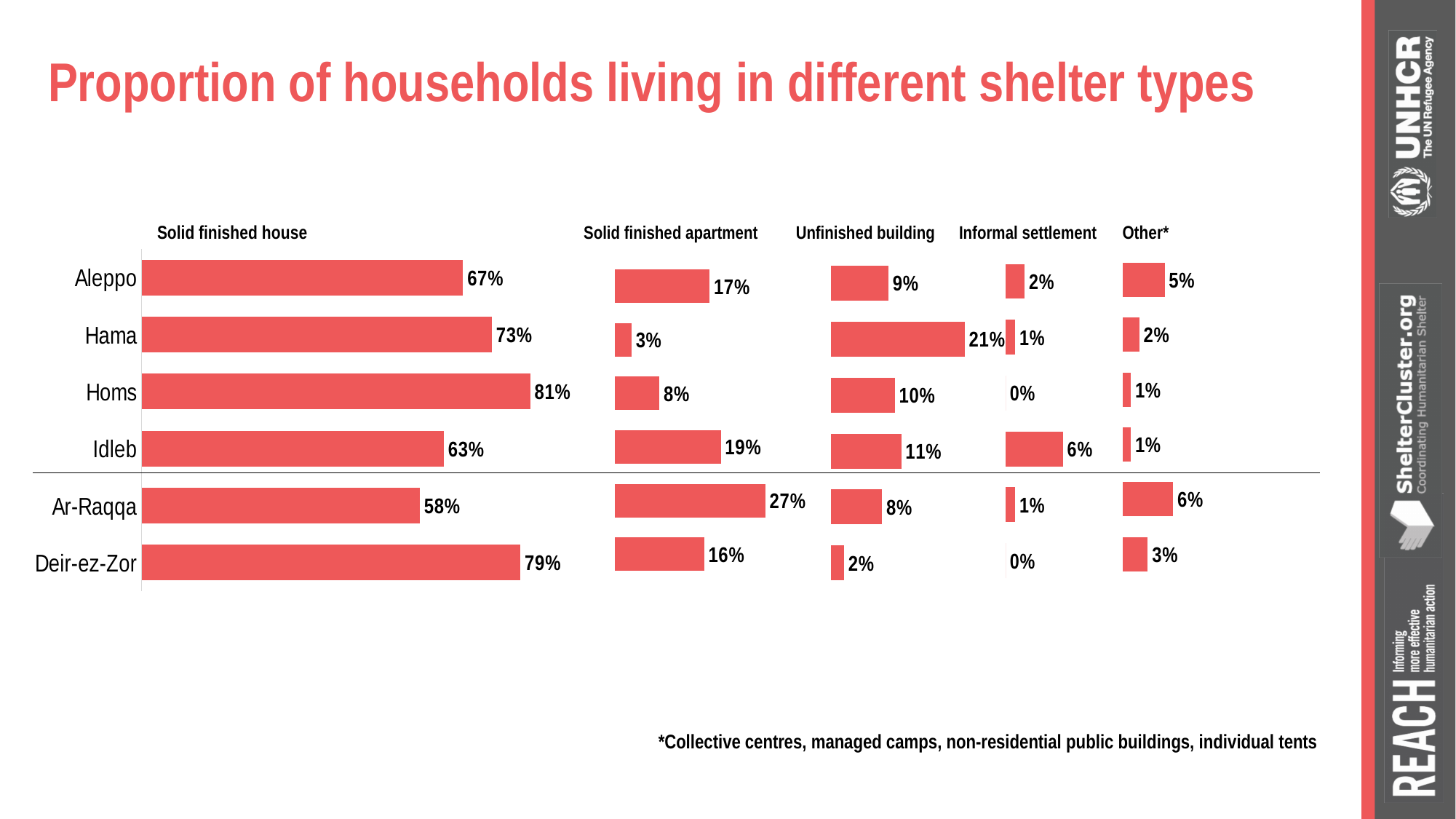
What proportion of households in Homs live in a solid finished house? 81% What proportion of households in Hama live in an unfinished building? 21% How many governorates are shown in the chart? 6 What is the difference between the solid finished house proportions for Deir-ez-Zor and Idleb? 16% What proportion of households in Ar-Raqqa live in a solid finished apartment? 27% Which governorate has the highest proportion of households living in a solid finished apartment? Ar-Raqqa What proportion of households in Idleb live in an informal settlement? 6% How many shelter type categories are shown in the chart? 5 Which governorate has the highest proportion of households living in a solid finished house? Homs Which is larger: the unfinished building proportion for Aleppo or for Homs? Homs Which governorate has the lowest proportion of households living in a solid finished house? Ar-Raqqa What type of chart is shown on the slide? Bar chart